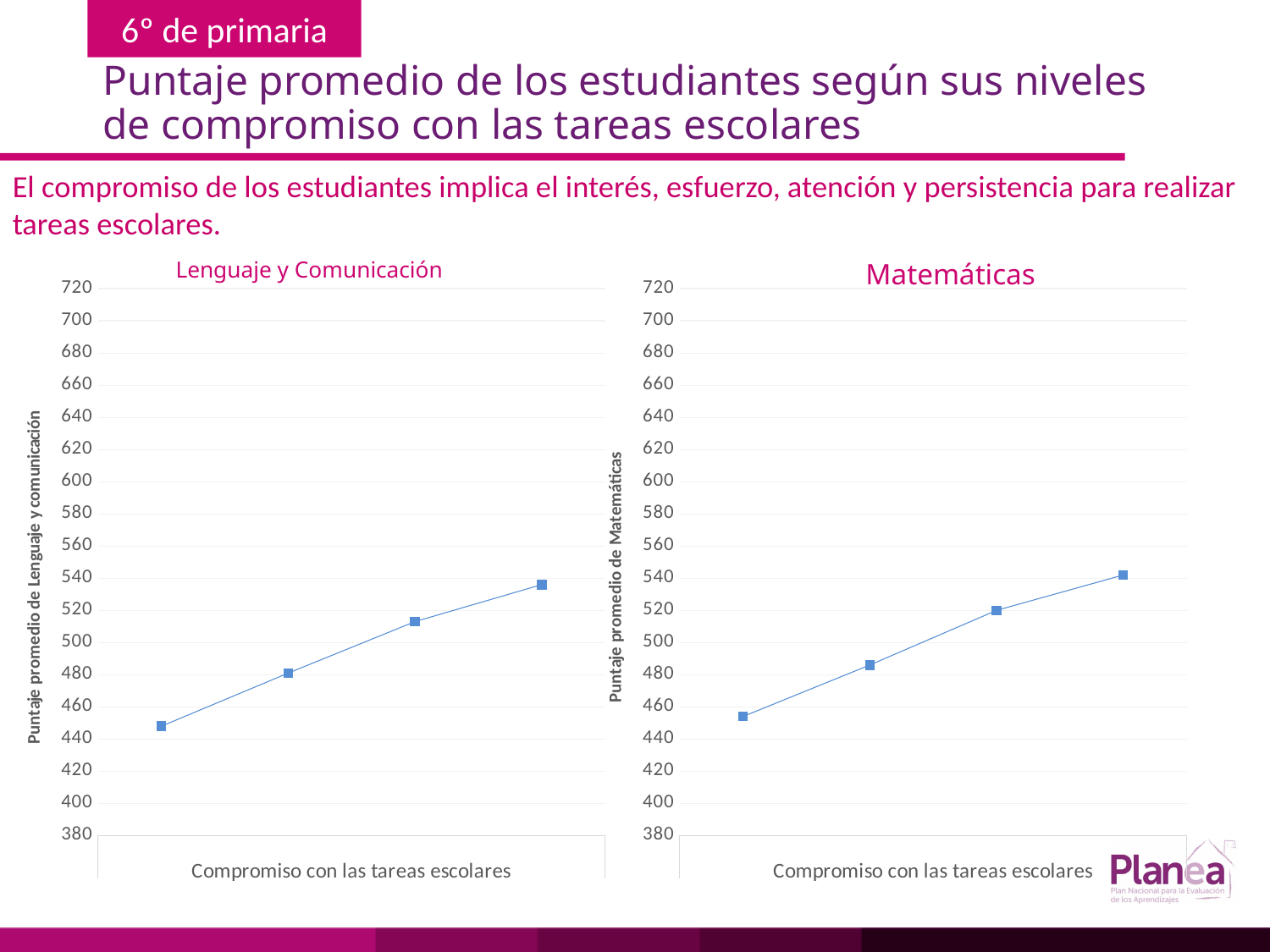
On the 'Matemáticas' chart, is the value of the leftmost point greater or less than 460? less On the 'Lenguaje y Comunicación' chart, do the values rise or fall from left to right along the x axis? rise On the 'Lenguaje y Comunicación' chart, is the value of the rightmost point greater or less than 520? greater How many data points are plotted on the 'Matemáticas' chart? 4 On the 'Matemáticas' chart, is the value of the rightmost point greater or less than 520? greater What kind of chart is the 'Lenguaje y Comunicación' chart? line chart What is the x-axis label on the 'Matemáticas' chart? Compromiso con las tareas escolares What is the y-axis label on the 'Lenguaje y Comunicación' chart? Puntaje promedio de Lenguaje y comunicación What kind of chart is the 'Matemáticas' chart? line chart On the 'Matemáticas' chart, do the values rise or fall from left to right along the x axis? rise How many data points are plotted on the 'Lenguaje y Comunicación' chart? 4